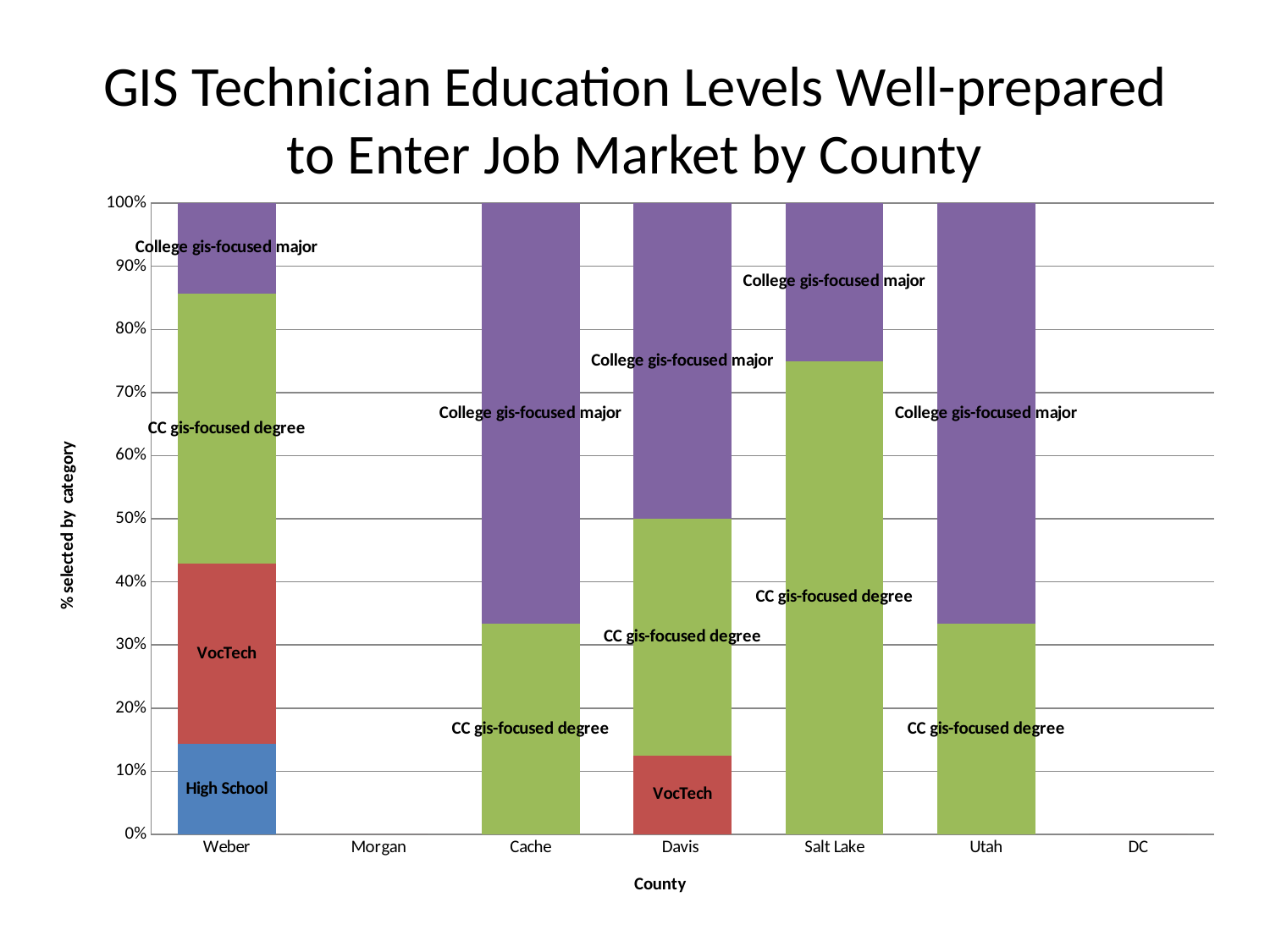
Is the top of the CC gis-focused degree segment for Cache greater or less than 30%? greater Is the top of the High School segment for Weber greater or less than 10%? greater Which counties have no bar plotted at all? Morgan and DC Which county has the larger CC gis-focused degree segment, Salt Lake or Cache? Salt Lake What is the label of the y axis? % selected by category Which counties have a VocTech segment in their bars? Weber and Davis How many counties are listed along the x axis? 7 Which county is the only one with a High School segment in its bar? Weber Is the top of the CC gis-focused degree segment for Salt Lake greater or less than 70%? greater Which county has the larger VocTech segment, Weber or Davis? Weber What is the title of the chart? GIS Technician Education Levels Well-prepared to Enter Job Market by County What kind of chart is shown on the slide? Stacked bar chart